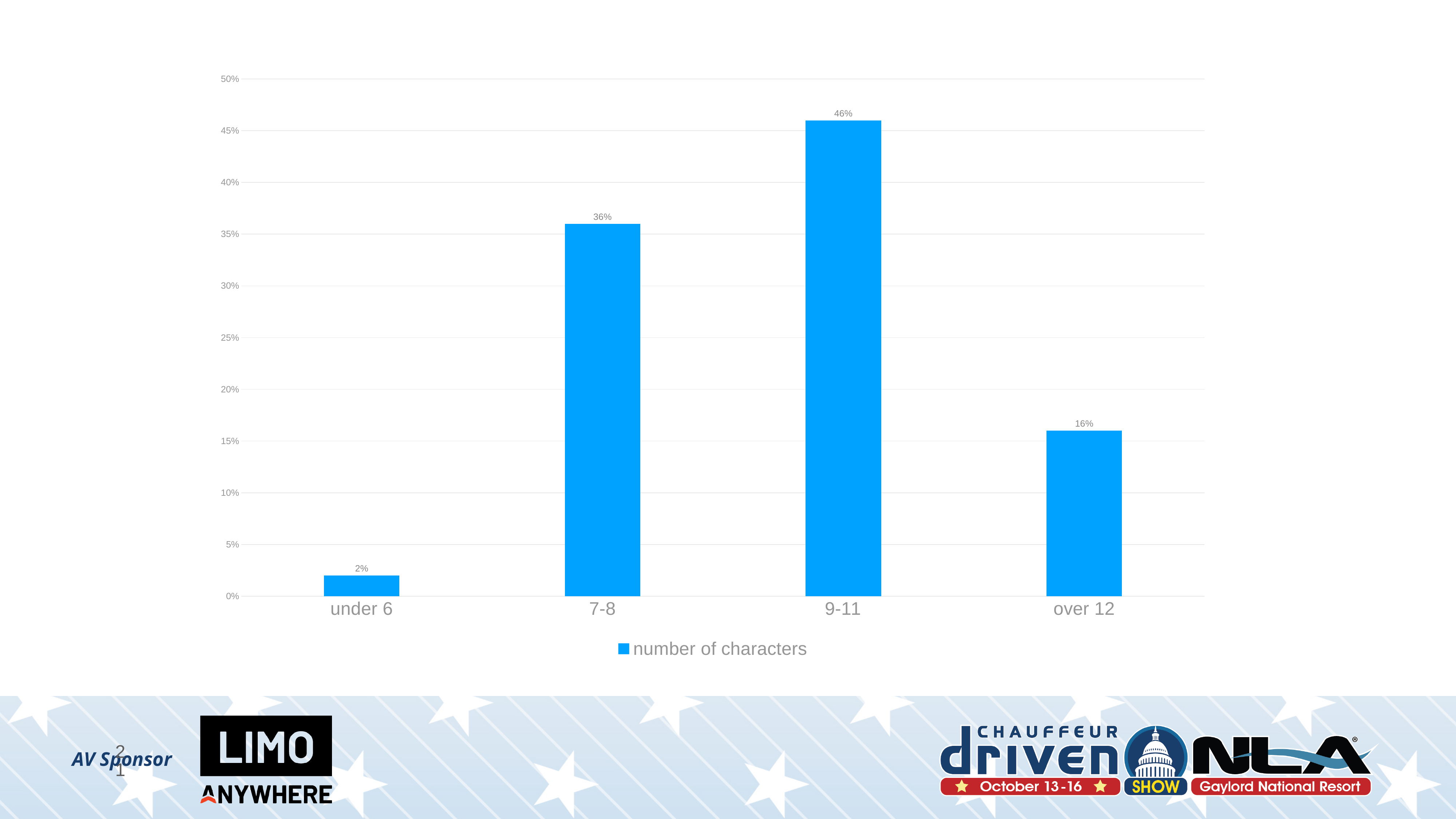
Which category has the lowest value? under 6 What is the difference between the values for "9-11" and "7-8"? 10% Which is larger, the value for "7-8" or the value for "over 12"? 7-8 What is the name of the series shown in the legend? number of characters How many categories are shown on the x axis? 4 Which category has the highest value? 9-11 What is the value for the "9-11" category? 46% What is the value for the "over 12" category? 16% How many series does the legend list? 1 What is the value for the "under 6" category? 2% What kind of chart is shown on the slide? bar chart Is the value for "7-8" greater or less than 30%? greater